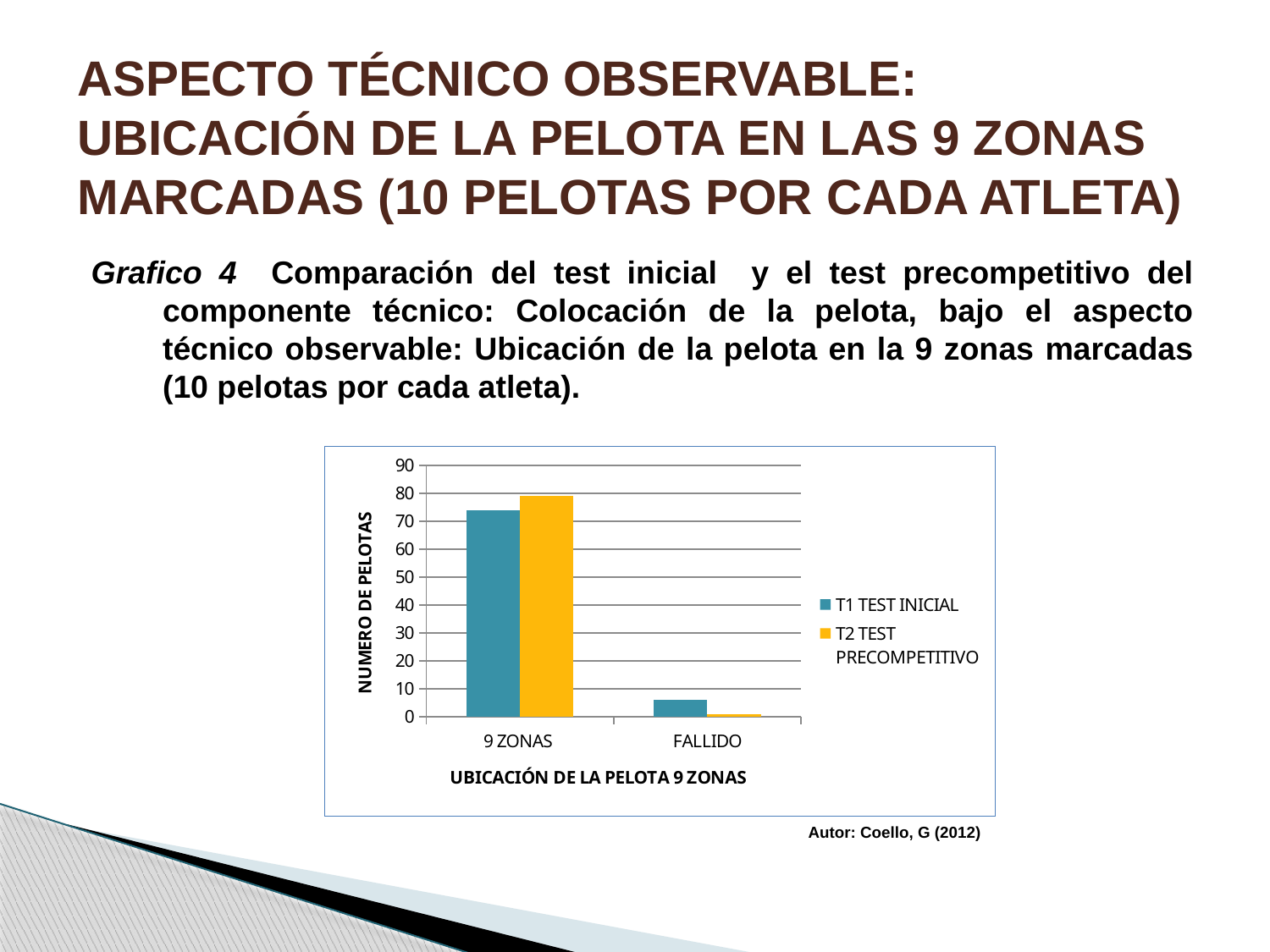
How many series does the chart's legend list? 2 What are the two series listed in the chart's legend? T1 TEST INICIAL and T2 TEST PRECOMPETITIVO Which category has the lowest values for both series in the chart? FALLIDO Is the value for T1 TEST INICIAL in the 9 ZONAS category greater or less than 80? less What kind of chart is shown on the slide? bar chart Is the value for T1 TEST INICIAL in the FALLIDO category greater or less than 10? less Is the value for T2 TEST PRECOMPETITIVO in the 9 ZONAS category greater or less than 70? greater What is the label of the vertical axis of the chart? NUMERO DE PELOTAS In the 9 ZONAS category, which series has the larger value, T1 TEST INICIAL or T2 TEST PRECOMPETITIVO? T2 TEST PRECOMPETITIVO In the FALLIDO category, which series has the larger value, T1 TEST INICIAL or T2 TEST PRECOMPETITIVO? T1 TEST INICIAL How many categories are shown on the x axis of the chart? 2